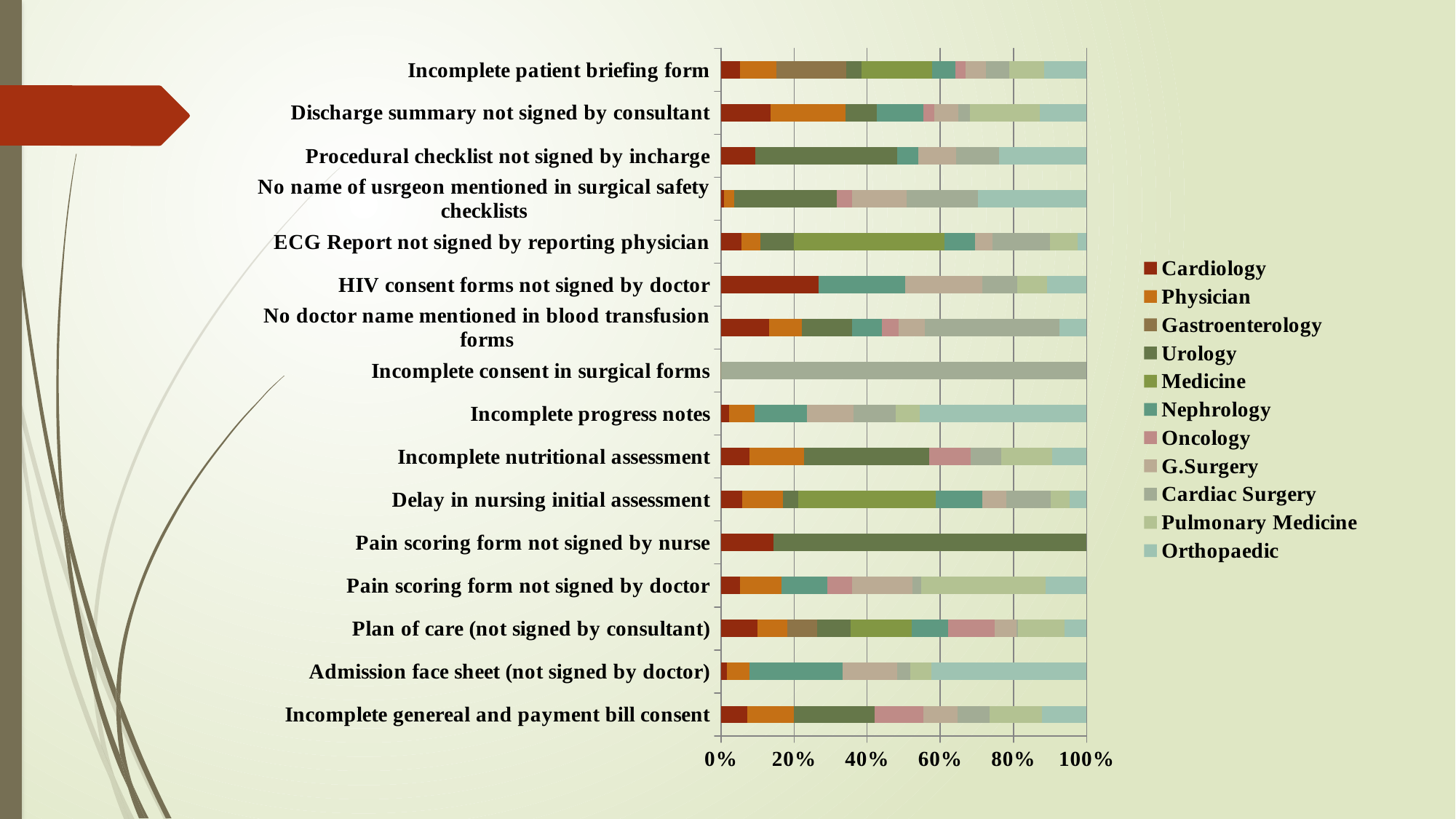
Is the Cardiac Surgery share for 'Incomplete consent in surgical forms' greater or less than 80%? greater How many series does the chart's legend list? 11 Which category has the largest Cardiology share? HIV consent forms not signed by doctor Which single series makes up the entire bar for 'Incomplete consent in surgical forms'? Cardiac Surgery Is the Cardiology share for 'HIV consent forms not signed by doctor' greater or less than 20%? greater What kind of chart is shown on the slide? Stacked bar chart Is the Orthopaedic share for 'Incomplete progress notes' greater or less than 40%? greater In the bar for 'Pain scoring form not signed by nurse', which is larger: the Urology segment or the Cardiology segment? Urology How many categories (deficiency types) are listed on the vertical axis of the chart? 16 Which series is listed first in the chart's legend? Cardiology What is the maximum value shown on the horizontal axis of the chart? 100%